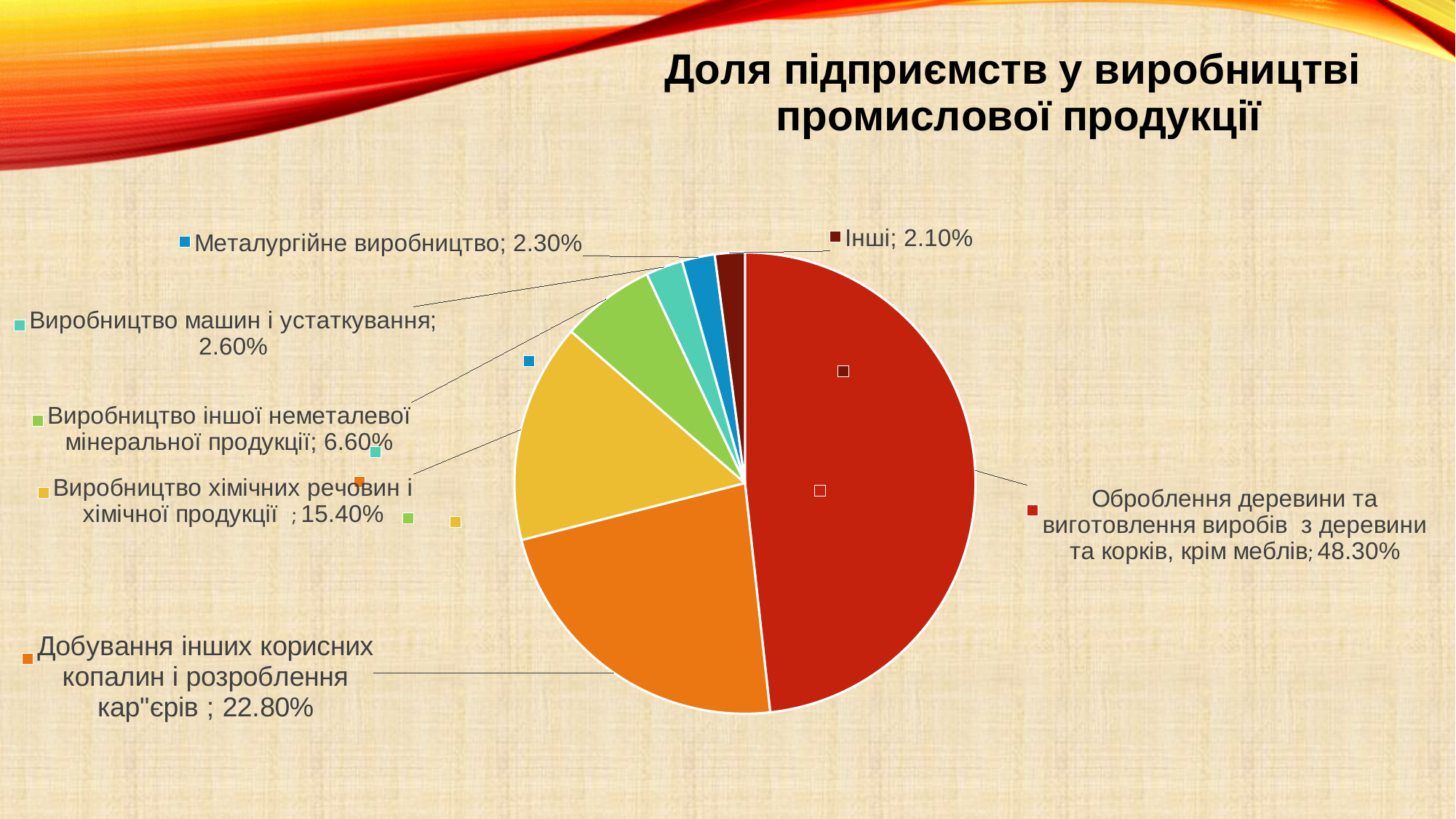
Which category has the largest share of the pie? Оброблення деревини та виготовлення виробів з деревини та корків, крім меблів What share is shown for "Металургійне виробництво"? 2.30% How many slices does the pie chart have? 7 Which is larger: the share for "Виробництво машин і устаткування" or the share for "Виробництво іншої неметалевої мінеральної продукції"? Виробництво іншої неметалевої мінеральної продукції Which category has the smallest share of the pie? Інші What is the difference in percentage points between "Добування інших корисних копалин і розроблення кар"єрів" and "Виробництво хімічних речовин і хімічної продукції"? 7.40% What share is shown for "Добування інших корисних копалин і розроблення кар"єрів"? 22.80% What share is shown for "Оброблення деревини та виготовлення виробів з деревини та корків, крім меблів"? 48.30% What type of chart is shown on the slide? pie chart What share is shown for "Виробництво хімічних речовин і хімічної продукції"? 15.40% What is the title of the chart? Доля підприємств у виробництві промислової продукції What share is shown for "Інші"? 2.10%